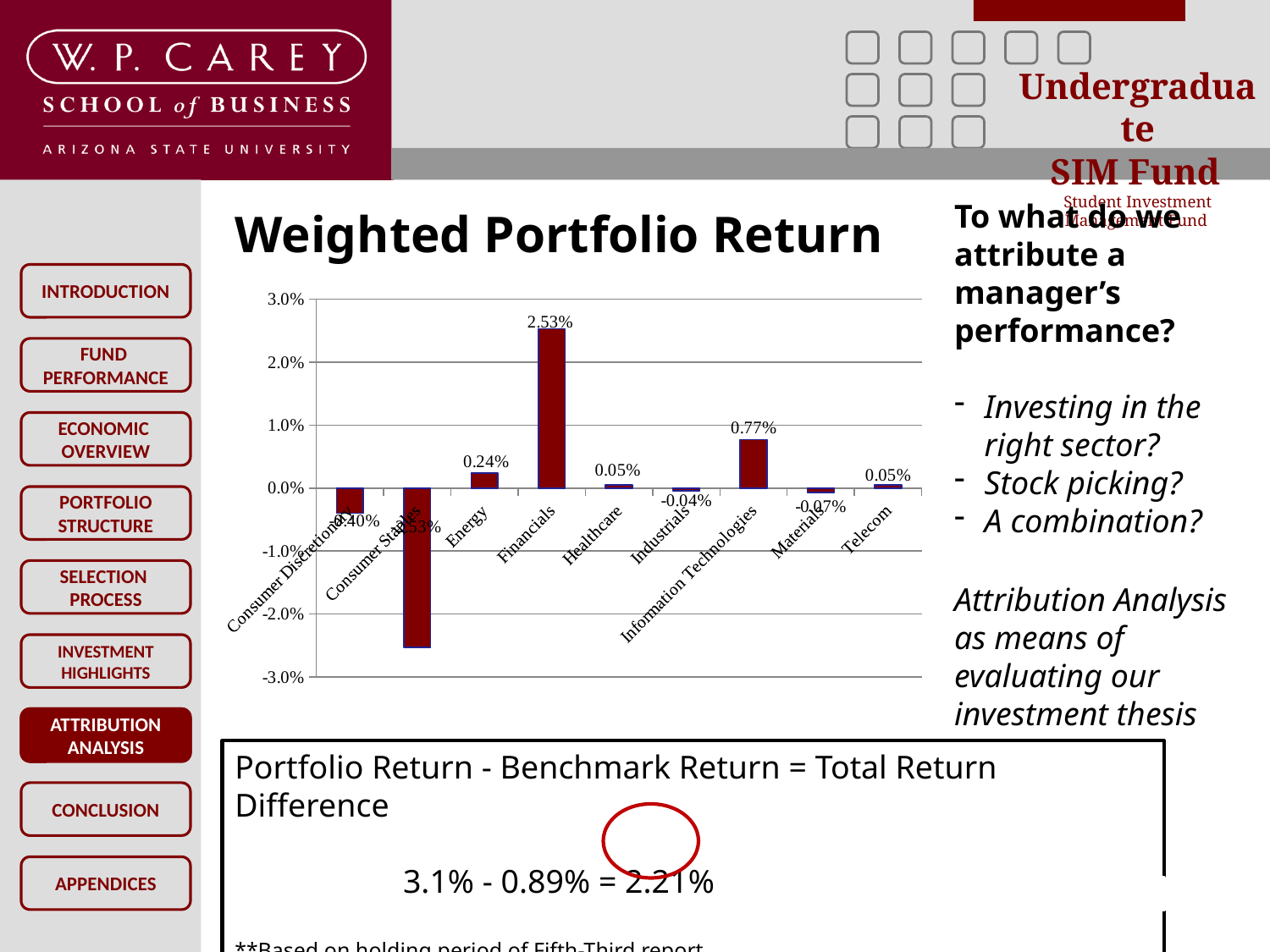
What is the difference between the returns for Financials and Information Technologies? 1.76% Which sector has the highest weighted portfolio return? Financials What is the weighted portfolio return for Information Technologies? 0.77% What kind of chart is shown on the slide? bar chart Which sector has the lowest weighted portfolio return? Consumer Staples What is the weighted portfolio return for Financials? 2.53% What is the weighted portfolio return for Energy? 0.24% What is the title of the chart? Weighted Portfolio Return What is the weighted portfolio return for Industrials? -0.04% What is the weighted portfolio return for Healthcare? 0.05% How many sectors are plotted in the chart? 9 Is the value for Consumer Staples greater or less than -2.0%? less